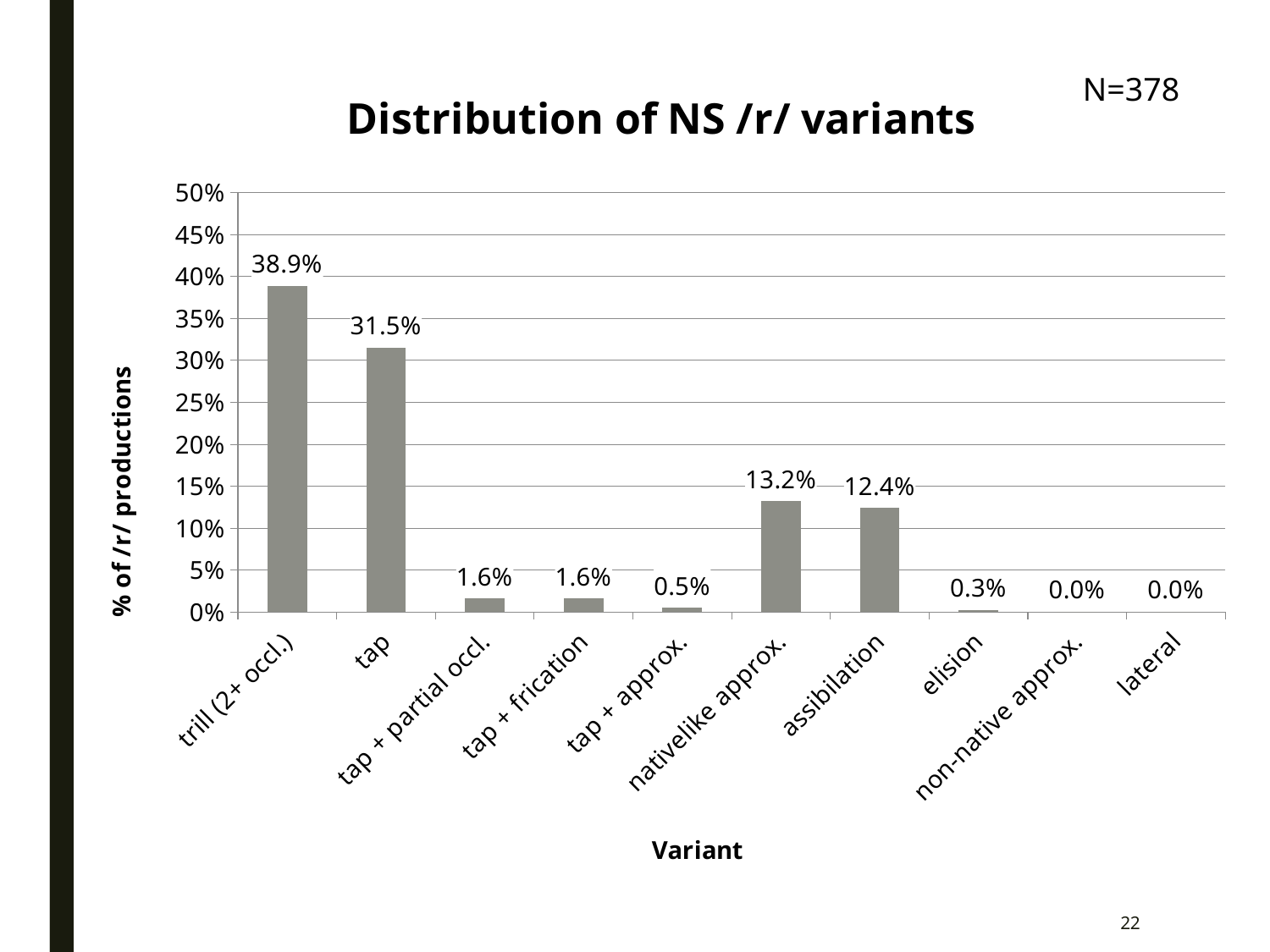
What is the value for elision? 0.3% What kind of chart is this? bar chart What is the title of the chart? Distribution of NS /r/ variants What is the label of the y axis? % of /r/ productions Is the value for tap greater or less than 30%? greater What is the difference between the values for trill (2+ occl.) and tap? 7.4% What is the value for trill (2+ occl.)? 38.9% Which variant has the highest percentage of /r/ productions? trill (2+ occl.) What is the value for tap + approx.? 0.5% What is the value for nativelike approx.? 13.2% Which is larger, the value for nativelike approx. or the value for assibilation? nativelike approx. How many variants are shown on the x axis? 10